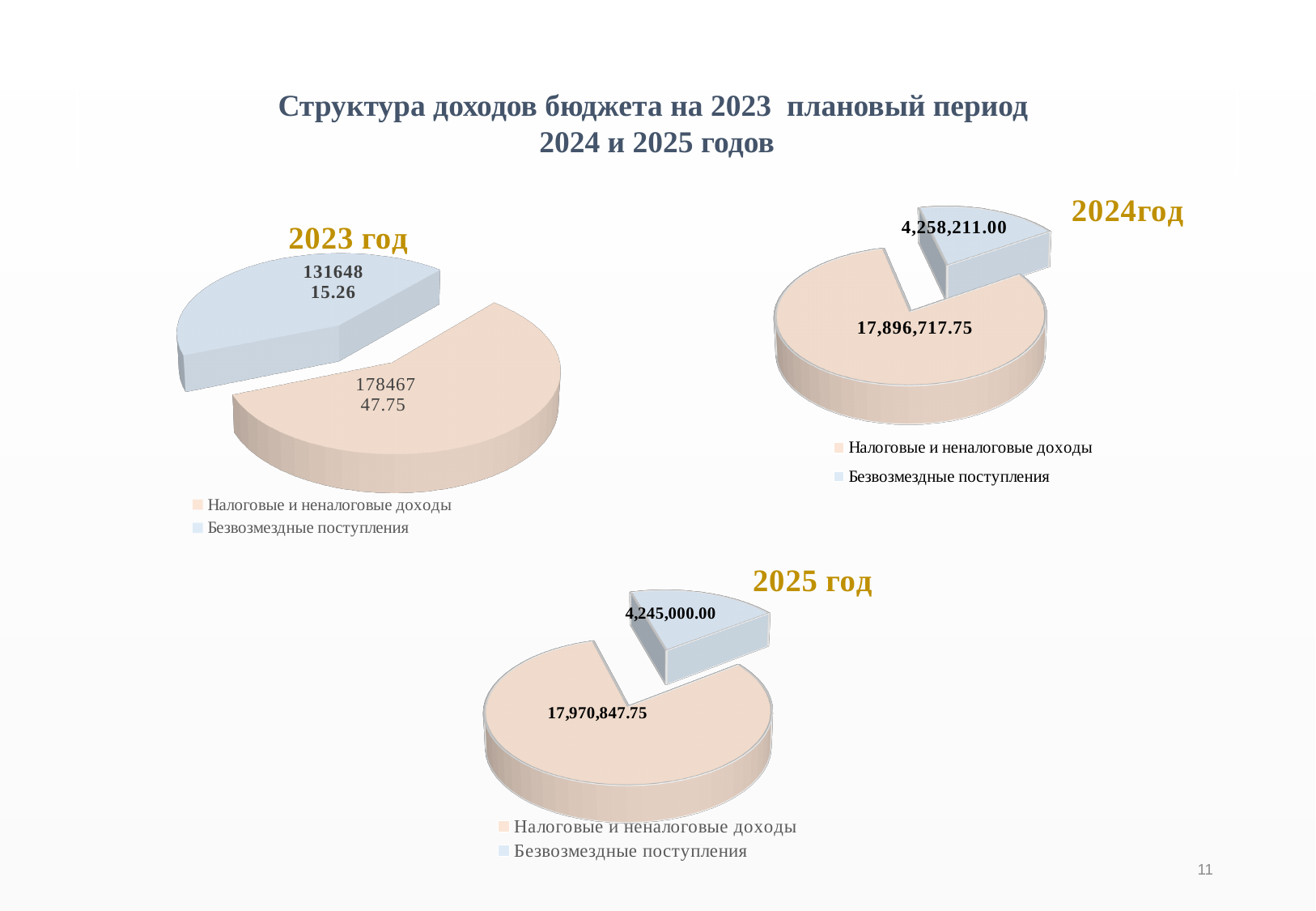
In the 2023 год chart, which is larger: Налоговые и неналоговые доходы or Безвозмездные поступления? Налоговые и неналоговые доходы In the 2024год chart, what value is shown for Налоговые и неналоговые доходы? 17,896,717.75 In the 2024год chart, which category has the largest slice? Налоговые и неналоговые доходы How many slices does the 2025 год chart have? 2 In the 2025 год chart, what value is shown for Налоговые и неналоговые доходы? 17,970,847.75 In the 2025 год chart, which category has the smallest slice? Безвозмездные поступления In the 2024год chart, what value is shown for Безвозмездные поступления? 4,258,211.00 In the 2025 год chart, what value is shown for Безвозмездные поступления? 4,245,000.00 In the 2023 год chart, what value is shown for Налоговые и неналоговые доходы? 178467 47.75 In the 2024год chart, what is the difference between Налоговые и неналоговые доходы and Безвозмездные поступления? 13,638,506.75 In the 2023 год chart, what value is shown for Безвозмездные поступления? 131648 15.26 What type of chart is the 2024год chart? Pie chart